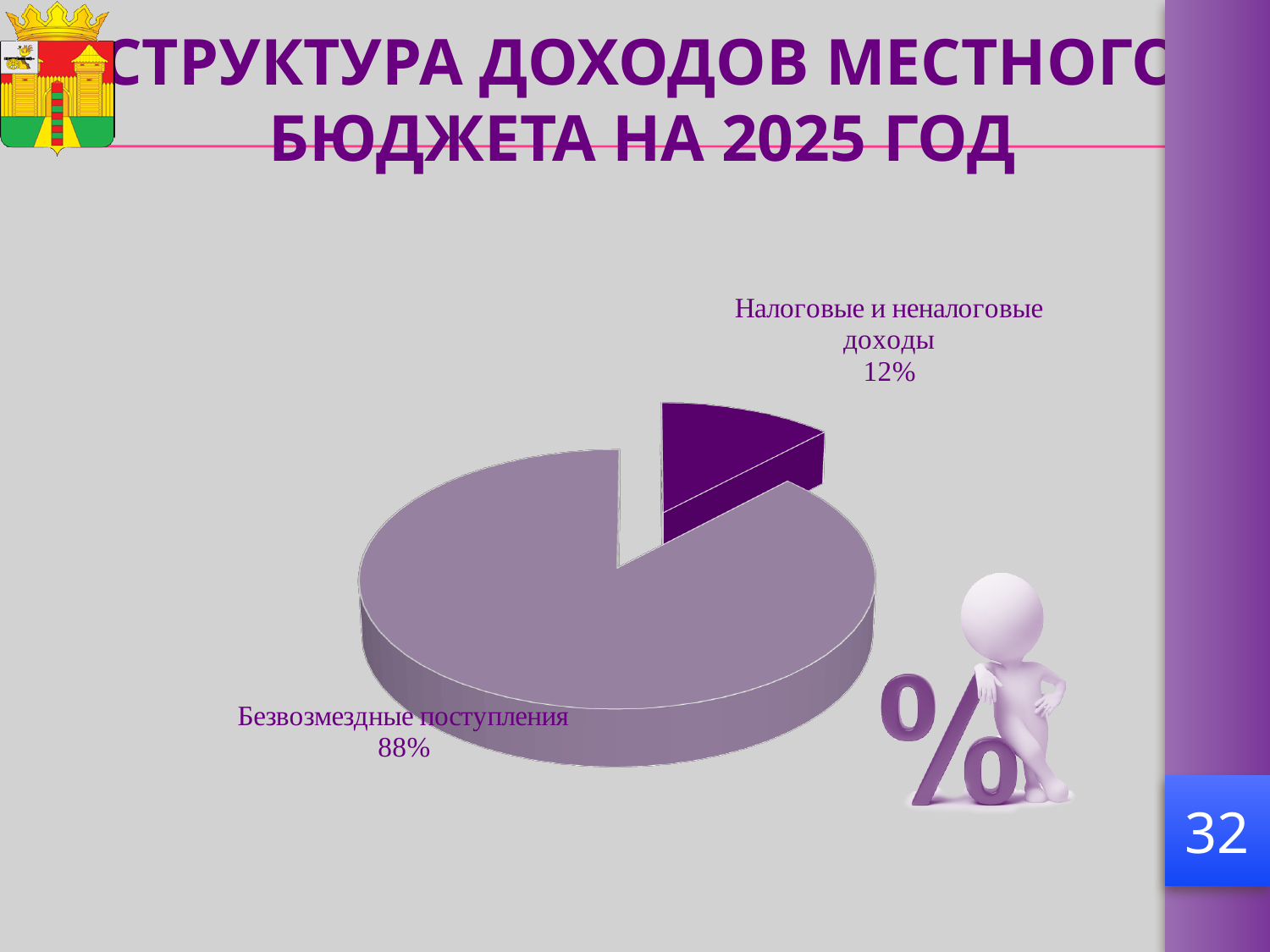
Which category has the largest slice of the pie? Безвозмездные поступления What share of the pie does "Безвозмездные поступления" have? 88% What is the difference in percentage points between "Безвозмездные поступления" and "Налоговые и неналоговые доходы"? 76 Which is larger: the share for "Безвозмездные поступления" or for "Налоговые и неналоговые доходы"? Безвозмездные поступления Which category has the smallest slice of the pie? Налоговые и неналоговые доходы What is the title of the slide containing the pie chart? СТРУКТУРА ДОХОДОВ МЕСТНОГО БЮДЖЕТА НА 2025 ГОД What share of the pie does "Налоговые и неналоговые доходы" have? 12% What kind of chart is shown on the slide? pie chart How many slices does the pie chart have? 2 Which slice of the pie is drawn in dark purple? Налоговые и неналоговые доходы